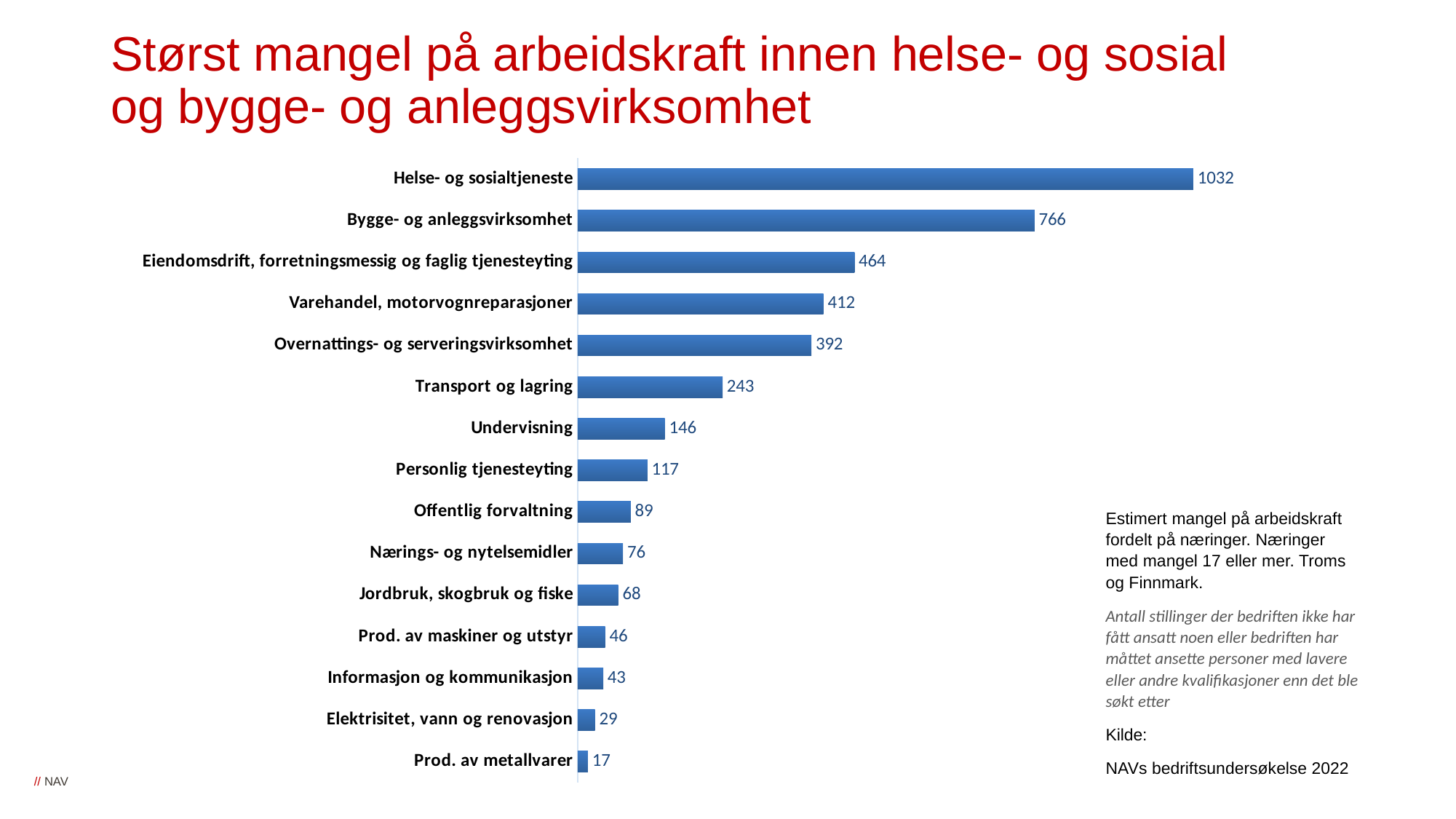
What is the value for Transport og lagring? 243 What is the difference between the values for Varehandel, motorvognreparasjoner and Overnattings- og serveringsvirksomhet? 20 What is the value for Informasjon og kommunikasjon? 43 What is the value for Helse- og sosialtjeneste? 1032 What source is cited for the chart data? NAVs bedriftsundersøkelse 2022 What is the difference between the values for Helse- og sosialtjeneste and Bygge- og anleggsvirksomhet? 266 Which category has the highest value? Helse- og sosialtjeneste Which category has the lowest value? Prod. av metallvarer How many categories are shown in the chart? 15 What kind of chart is shown on the slide? Bar chart What is the value for Jordbruk, skogbruk og fiske? 68 Which is larger, the value for Undervisning or the value for Personlig tjenesteyting? Undervisning